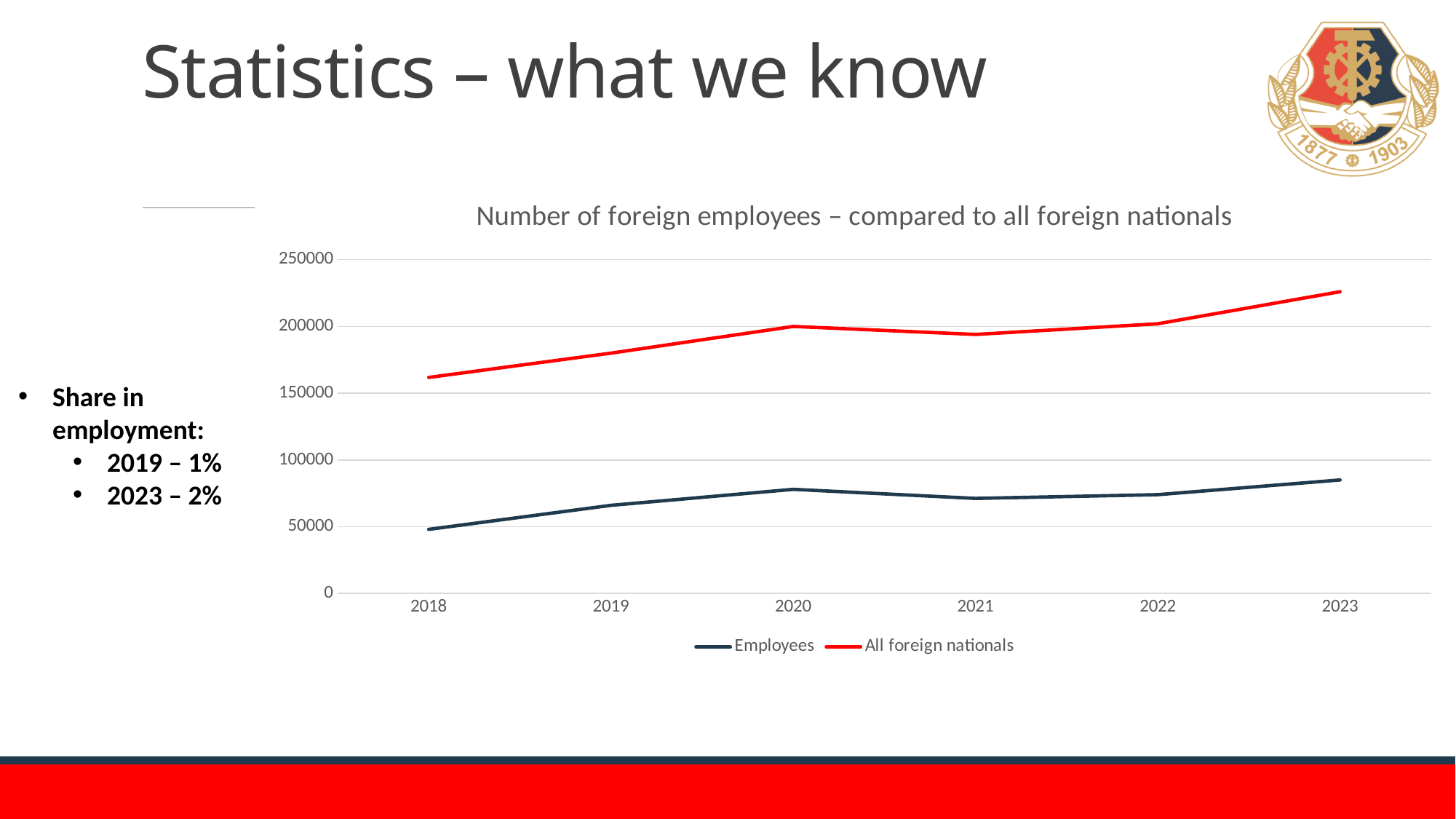
In which year is the 'All foreign nationals' value highest? 2023 Does the 'All foreign nationals' line rise or fall from 2018 to 2020? rise What is the title of the chart? Number of foreign employees – compared to all foreign nationals What kind of chart is shown on the slide? line chart In which year is the 'Employees' value highest? 2023 How many series does the chart legend list? 2 Which colour is used for the 'All foreign nationals' line? red Which series has the larger value in 2020, 'Employees' or 'All foreign nationals'? All foreign nationals How many years are shown on the x axis of the chart? 6 Is the 'All foreign nationals' value for 2023 greater or less than 200000? greater In which year is the 'Employees' value lowest? 2018